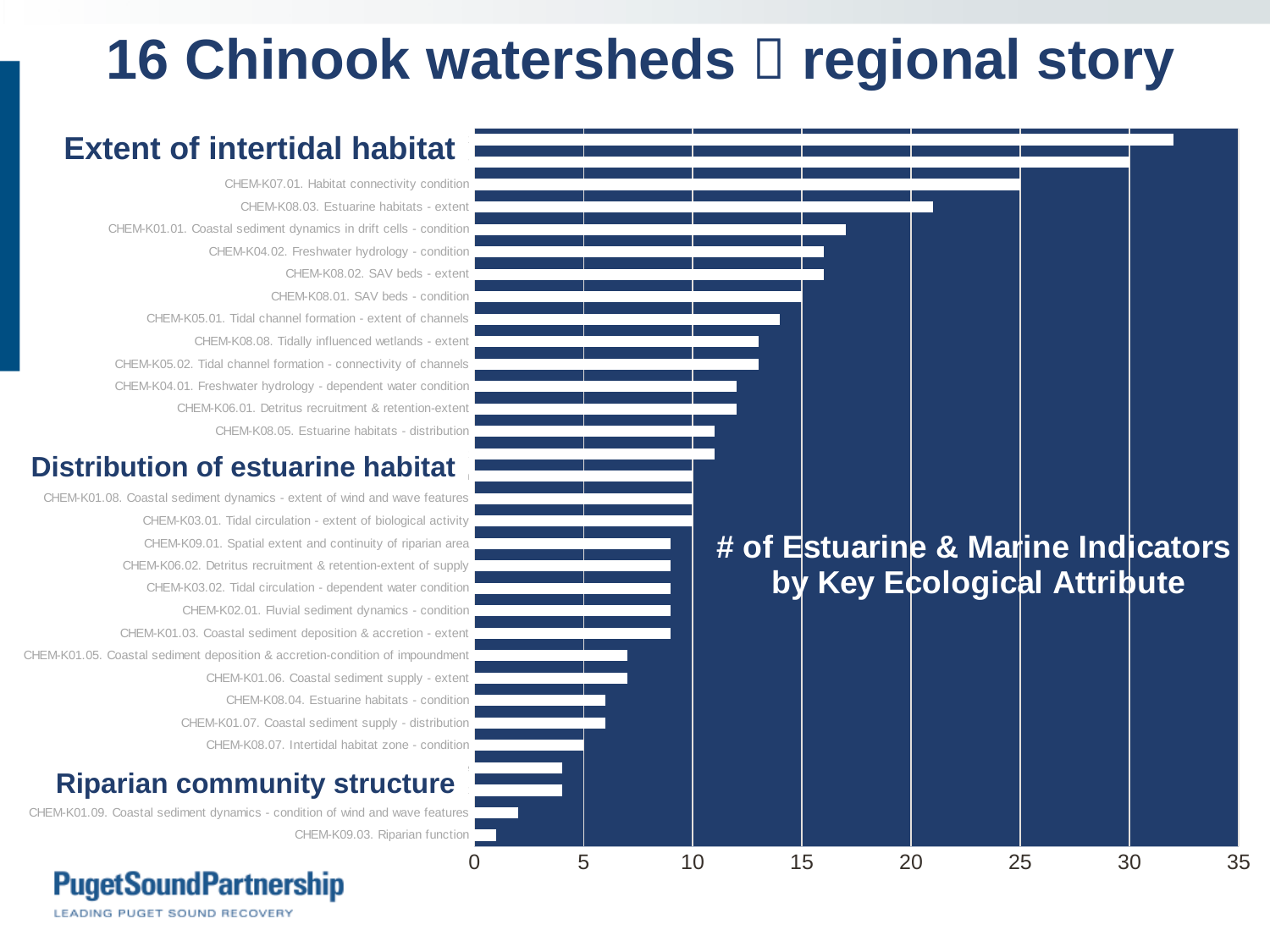
Is the value for CHEM-K07.01. Habitat connectivity condition greater or less than 20? greater Which labelled category has the shortest bar? CHEM-K09.03. Riparian function Is the value for CHEM-K08.04. Estuarine habitats - condition greater or less than 10? less Is the value for CHEM-K09.03. Riparian function greater or less than 5? less What is the highest value shown on the chart's horizontal axis? 35 What is the title printed inside the chart area? # of Estuarine & Marine Indicators by Key Ecological Attribute Which has the larger value: CHEM-K07.01. Habitat connectivity condition or CHEM-K08.03. Estuarine habitats - extent? CHEM-K07.01. Habitat connectivity condition Which has the larger value: CHEM-K01.01. Coastal sediment dynamics in drift cells - condition or CHEM-K01.06. Coastal sediment supply - extent? CHEM-K01.01. Coastal sediment dynamics in drift cells - condition What kind of chart is shown on the slide? bar chart